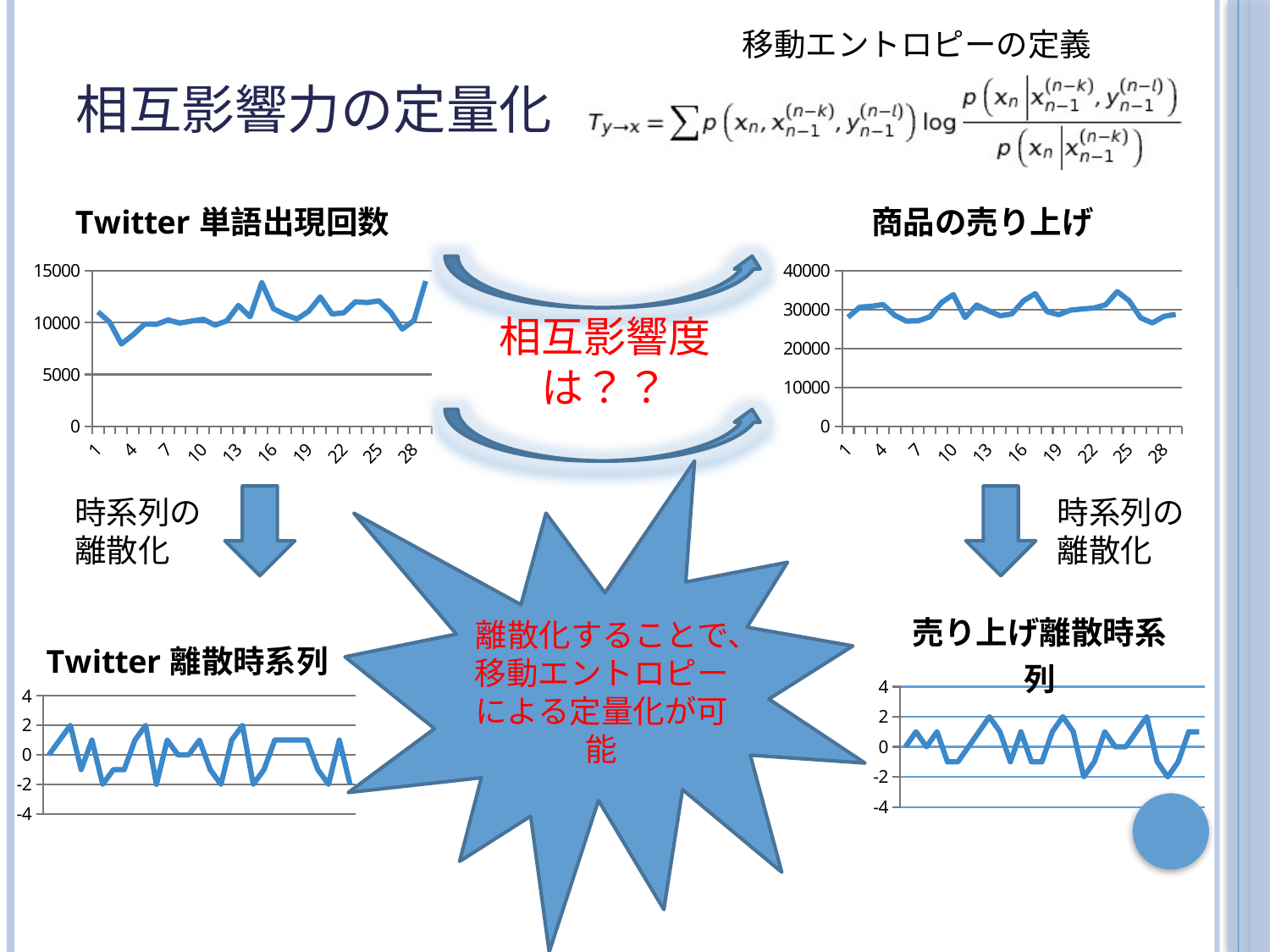
In the "Twitter 単語出現回数" chart, is the value at x = 3 greater or less than 10000? less In the "商品の売り上げ" chart, is the value at x = 25 greater or less than 30000? greater In the "Twitter 離散時系列" chart, what is the lowest tick value shown on the y-axis? -4 What is the highest tick value on the y-axis of the "商品の売り上げ" chart? 40000 What is the highest tick value on the y-axis of the "Twitter 単語出現回数" chart? 15000 In the "Twitter 単語出現回数" chart, is the value at x = 15 greater or less than 10000? greater What kind of chart is the "商品の売り上げ" chart? line chart What kind of chart is the "Twitter 単語出現回数" chart? line chart